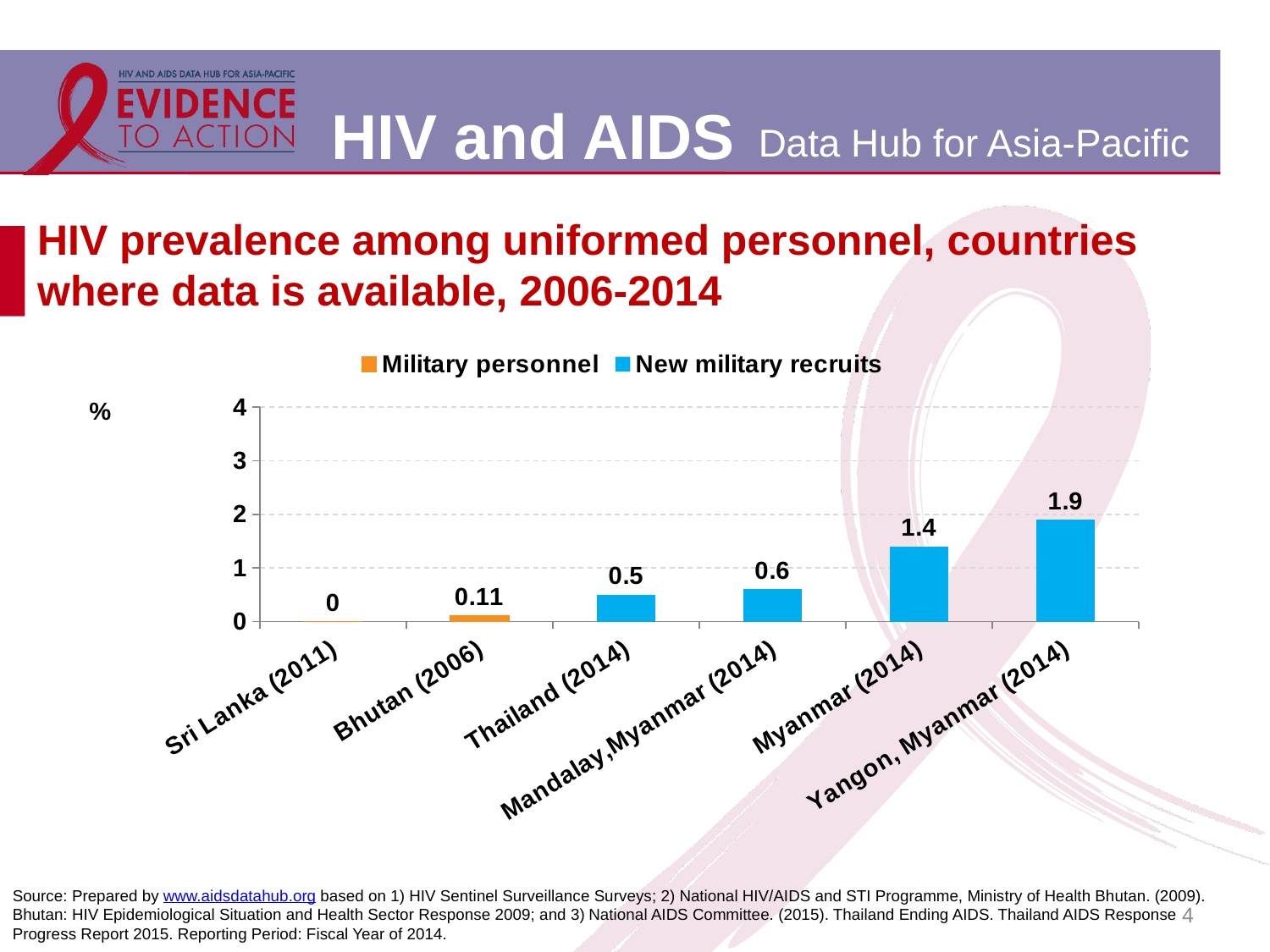
What is the HIV prevalence value shown for Sri Lanka (2011)? 0 What is the difference between the values for Yangon, Myanmar (2014) and Myanmar (2014)? 0.5 Which category has the lowest HIV prevalence value on the chart? Sri Lanka (2011) What is the HIV prevalence value shown for Thailand (2014)? 0.5 Is the value for Myanmar (2014) greater or less than 1? greater Which has a larger value, Thailand (2014) or Mandalay,Myanmar (2014)? Mandalay,Myanmar (2014) What is the HIV prevalence value shown for Yangon, Myanmar (2014)? 1.9 How many categories are shown on the x axis of the chart? 6 Which category has the highest HIV prevalence value on the chart? Yangon, Myanmar (2014) What type of chart is shown on the slide? Bar chart What is the HIV prevalence value shown for Bhutan (2006)? 0.11 How many series does the chart legend list? 2